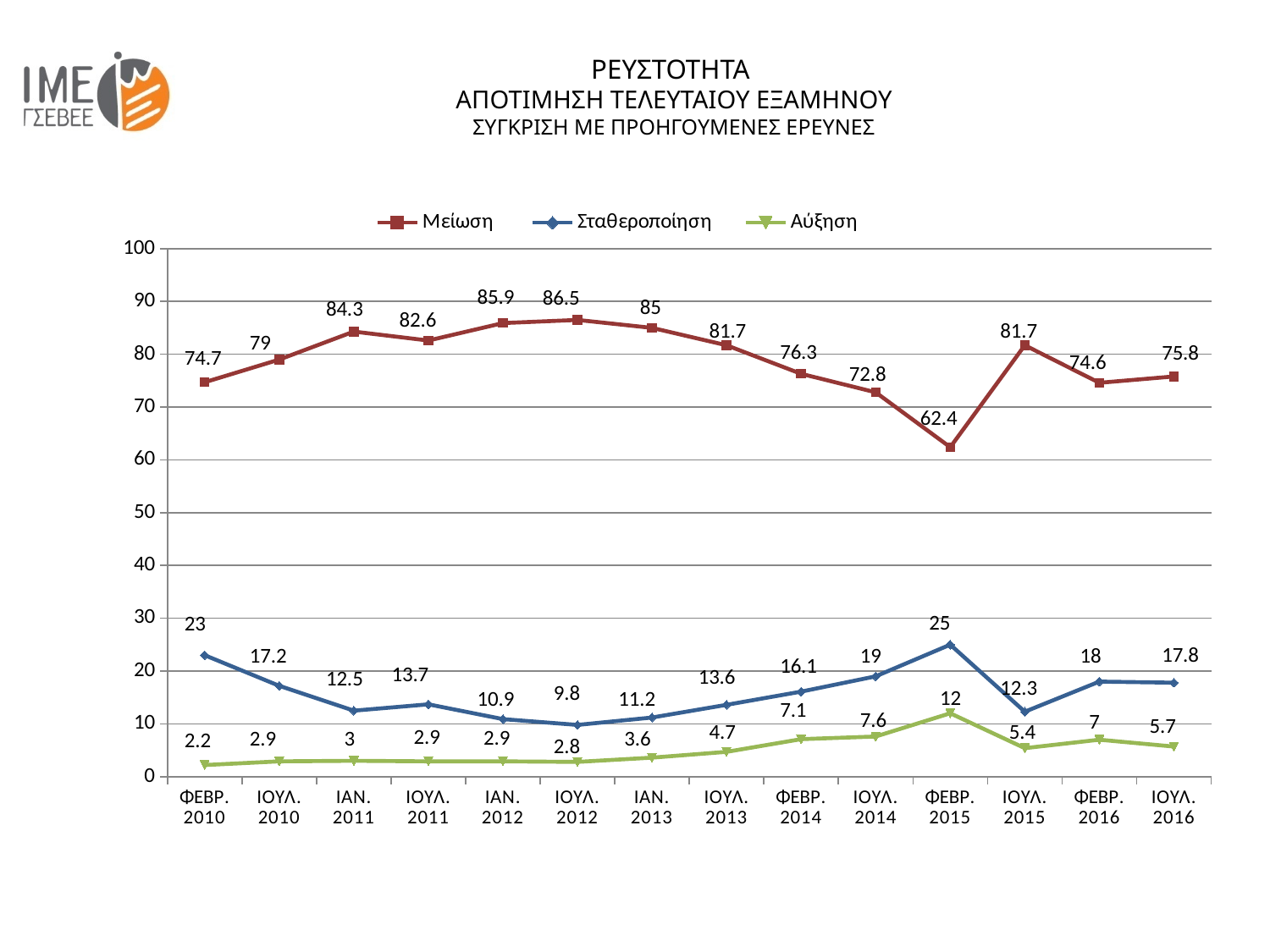
In which period is Αύξηση at its highest? ΦΕΒΡ. 2015 In which period is Μείωση at its lowest? ΦΕΒΡ. 2015 How many time periods are shown on the x axis? 14 What kind of chart is shown? line chart What is the difference between Μείωση in ΙΟΥΛ. 2015 and ΦΕΒΡ. 2015? 19.3 What is the value of Σταθεροποίηση for ΦΕΒΡ. 2015? 25 Which is larger: Σταθεροποίηση in ΦΕΒΡ. 2010 or in ΙΟΥΛ. 2010? ΦΕΒΡ. 2010 How many series does the legend list? 3 What is the value of Μείωση for ΙΟΥΛ. 2012? 86.5 Does Μείωση rise or fall from ΙΟΥΛ. 2012 to ΦΕΒΡ. 2015? fall Which series is drawn in green? Αύξηση What is the value of Αύξηση for ΙΟΥΛ. 2016? 5.7